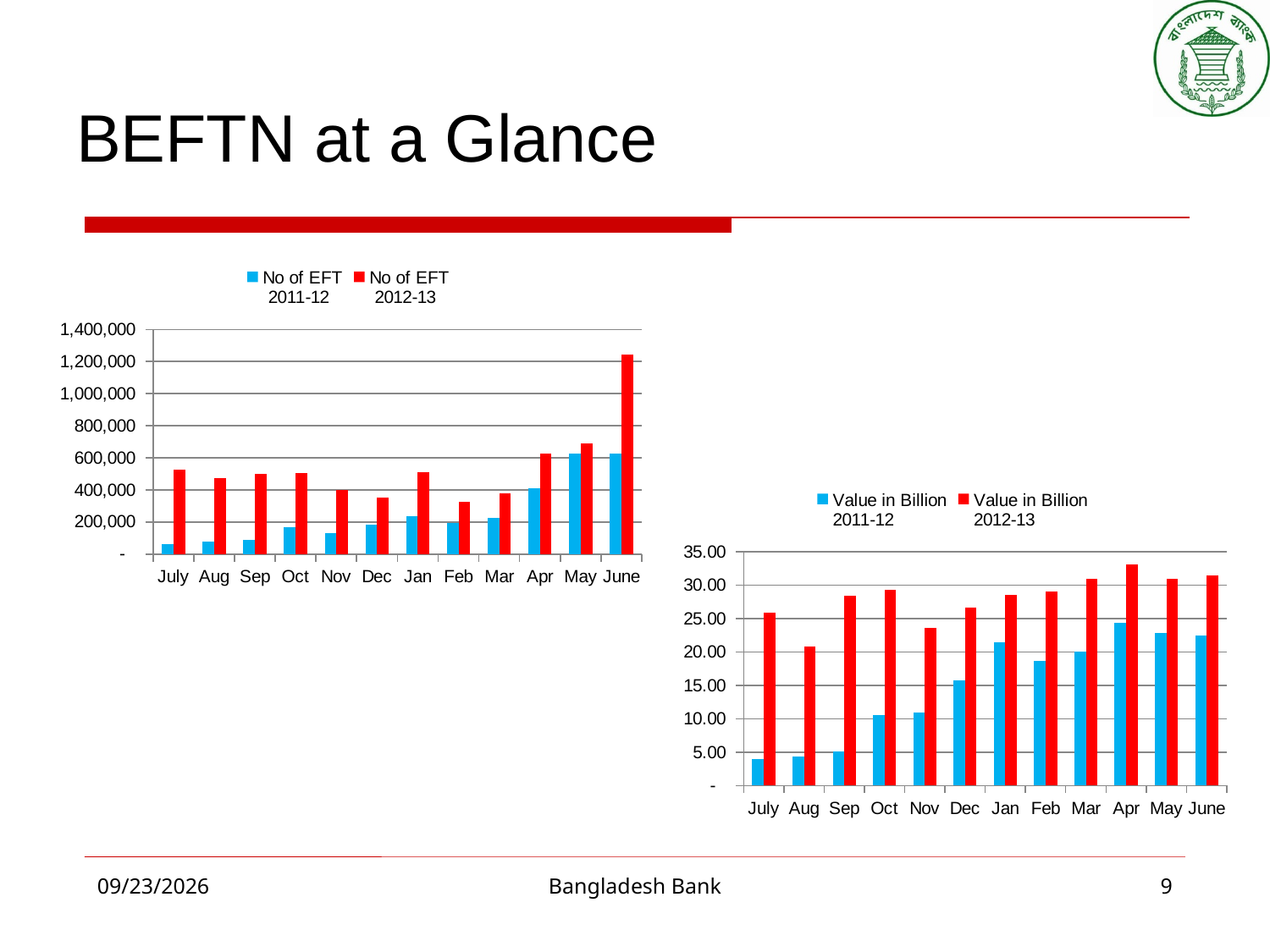
What kind of chart is the left chart showing No of EFT? bar chart In the right chart (Value in Billion), is the 2011-12 value for July greater or less than 5.00? less How many series does the legend of the right chart (Value in Billion) list? 2 In the left chart (No of EFT), which month has the highest value for the 2012-13 series? June In the left chart (No of EFT), is the 2012-13 value for June greater or less than 1,000,000? greater In the right chart (Value in Billion), which month has the highest value for the 2012-13 series? Apr In the left chart (No of EFT), is the 2012-13 value for Dec greater or less than 400,000? less In the left chart (No of EFT), which month has the lowest value for the 2011-12 series? July In the right chart (Value in Billion), which month has the lowest value for the 2011-12 series? July In the left chart (No of EFT), which series has the larger value in July, 2011-12 or 2012-13? 2012-13 How many months are shown on the x axis of the left chart (No of EFT)? 12